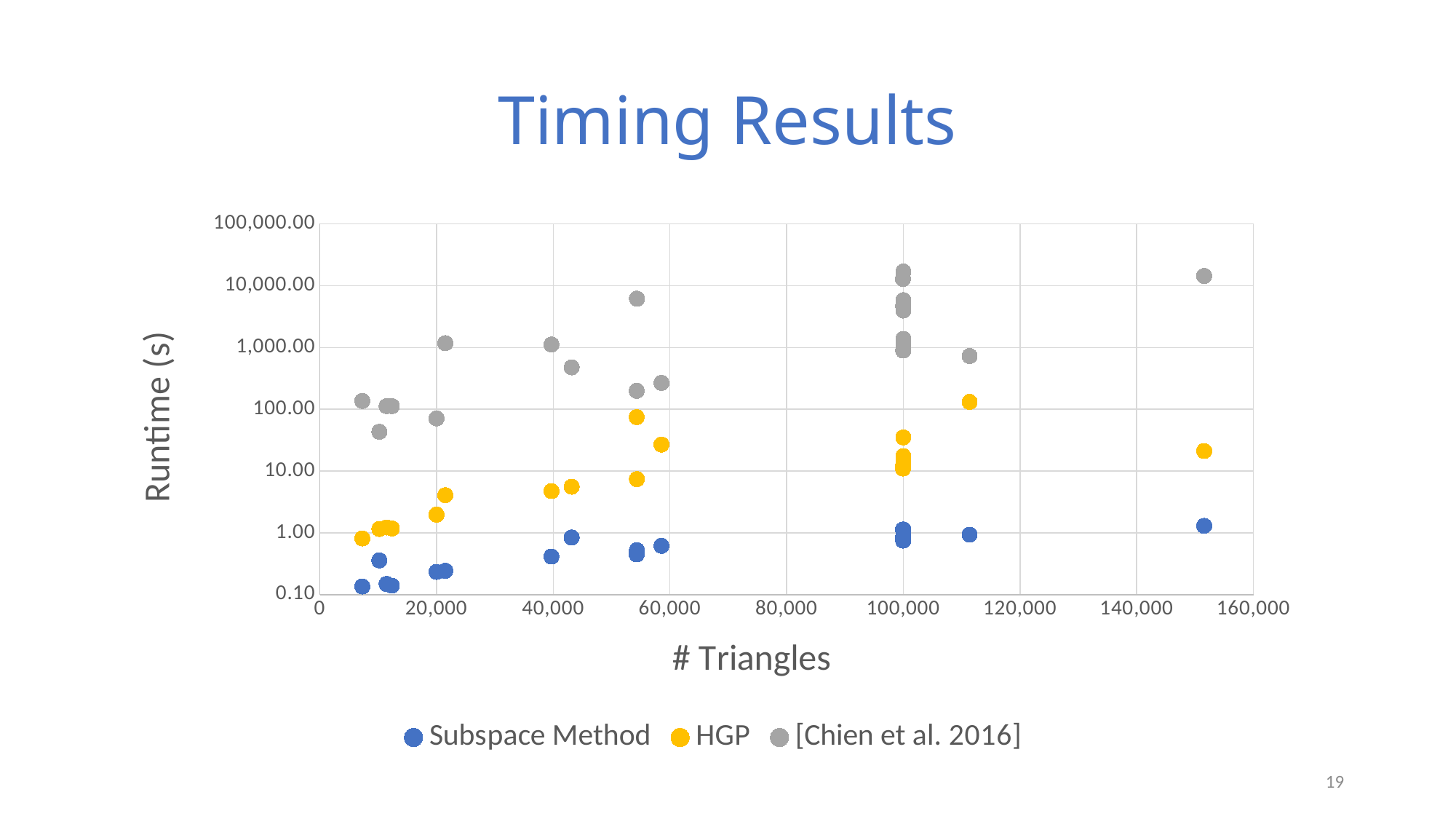
Is the runtime of the Subspace Method point at about 152,000 triangles greater or less than 10.00 seconds? less Is the runtime of the HGP point at about 152,000 triangles greater or less than 10.00 seconds? greater Which series contains the point with the lowest runtime on the chart? Subspace Method Is the runtime of the HGP point at about 111,000 triangles greater or less than 100.00 seconds? greater What is the label of the y axis? Runtime (s) Which series contains the point with the highest runtime on the chart? [Chien et al. 2016] At about 152,000 triangles, which series has the larger runtime, Subspace Method or [Chien et al. 2016]? [Chien et al. 2016] What kind of chart is shown on the slide? scatter chart How many series does the legend list? 3 Do the Subspace Method runtimes generally rise or fall as the number of triangles increases? rise What is the title of the chart? Timing Results